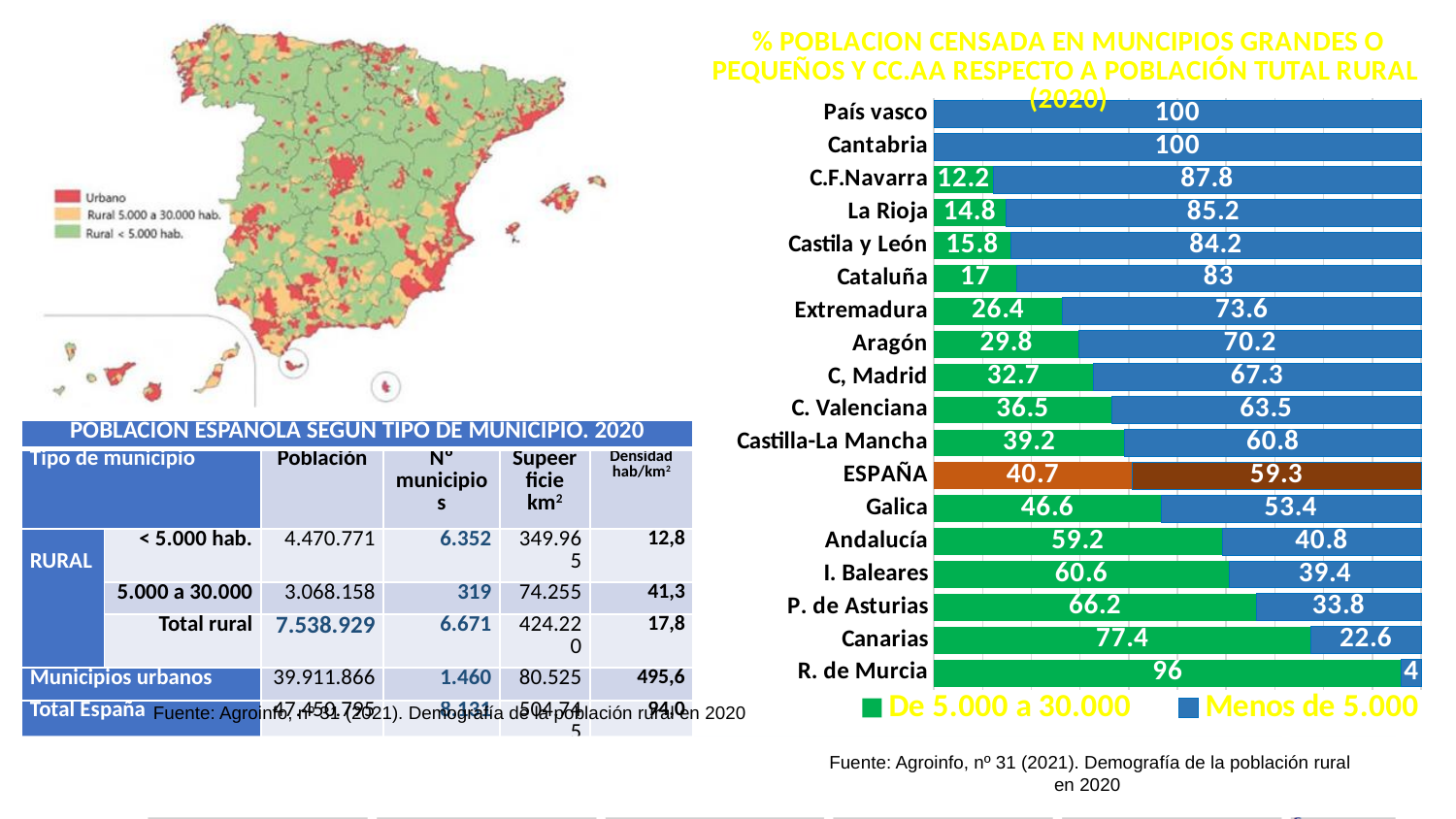
In the bar chart, what is the total of the stacked bar for Galica? 100 How many regions (categories) are shown in the bar chart? 18 In the bar chart, what is the difference between the 'Menos de 5.000' values for Cataluña and Aragón? 12.8 In the bar chart, which is larger: the 'De 5.000 a 30.000' value for Canarias or for P. de Asturias? Canarias How many series does the legend of the bar chart list? 2 In the bar chart, what is the value of 'Menos de 5.000' for Andalucía? 40.8 What type of chart is shown on the right side of the slide? Stacked bar chart In the bar chart, which region has the highest value for 'De 5.000 a 30.000'? R. de Murcia In the bar chart, which colour represents the series 'Menos de 5.000'? Blue In the bar chart, which region has the lowest value for 'Menos de 5.000'? R. de Murcia In the bar chart, what is the value of 'De 5.000 a 30.000' for Extremadura? 26.4 In the bar chart, what is the value of 'De 5.000 a 30.000' for ESPAÑA? 40.7